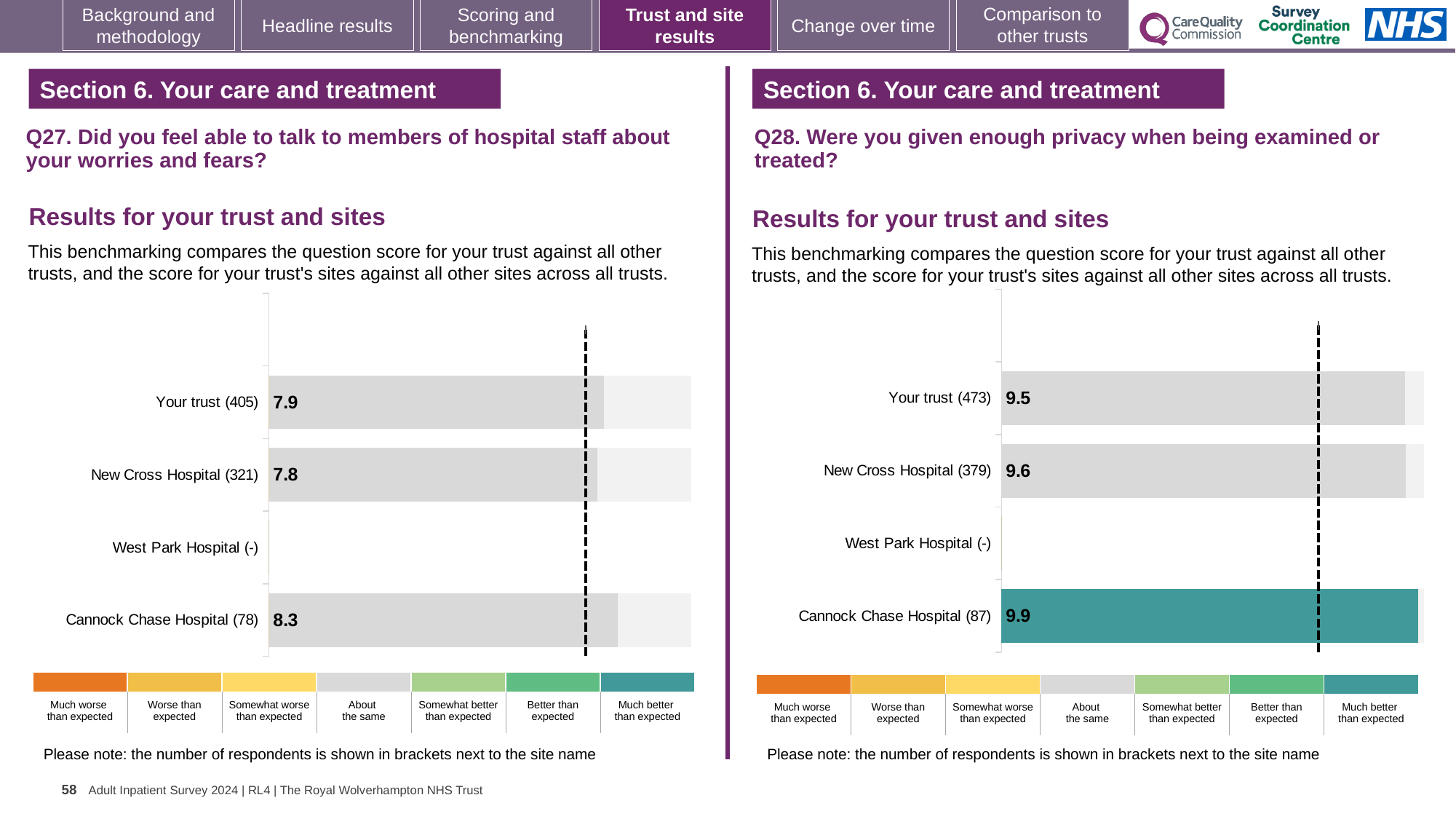
In the Q28 chart on the right, which has the larger score, Your trust or Cannock Chase Hospital? Cannock Chase Hospital In the Q27 chart on the left, what is the score for Your trust? 7.9 What kind of chart is used in the Q27 chart on the left? Bar chart In the Q27 chart on the left, what is the score for Cannock Chase Hospital? 8.3 In the Q27 chart on the left, what is the difference between the scores for Cannock Chase Hospital and New Cross Hospital? 0.5 In the Q28 chart on the right, what is the score for New Cross Hospital? 9.6 How many respondents are shown in brackets for Your trust in the Q28 chart on the right? 473 In the Q28 chart on the right, what is the difference between the scores for Cannock Chase Hospital and Your trust? 0.4 In the Q28 chart on the right, what is the score for Cannock Chase Hospital? 9.9 In the Q28 chart on the right, which benchmark category does the colour of the Cannock Chase Hospital bar indicate? Much better than expected In the Q27 chart on the left, which site or trust has the highest score? Cannock Chase Hospital In the Q28 chart on the right, which site or trust has the highest score? Cannock Chase Hospital